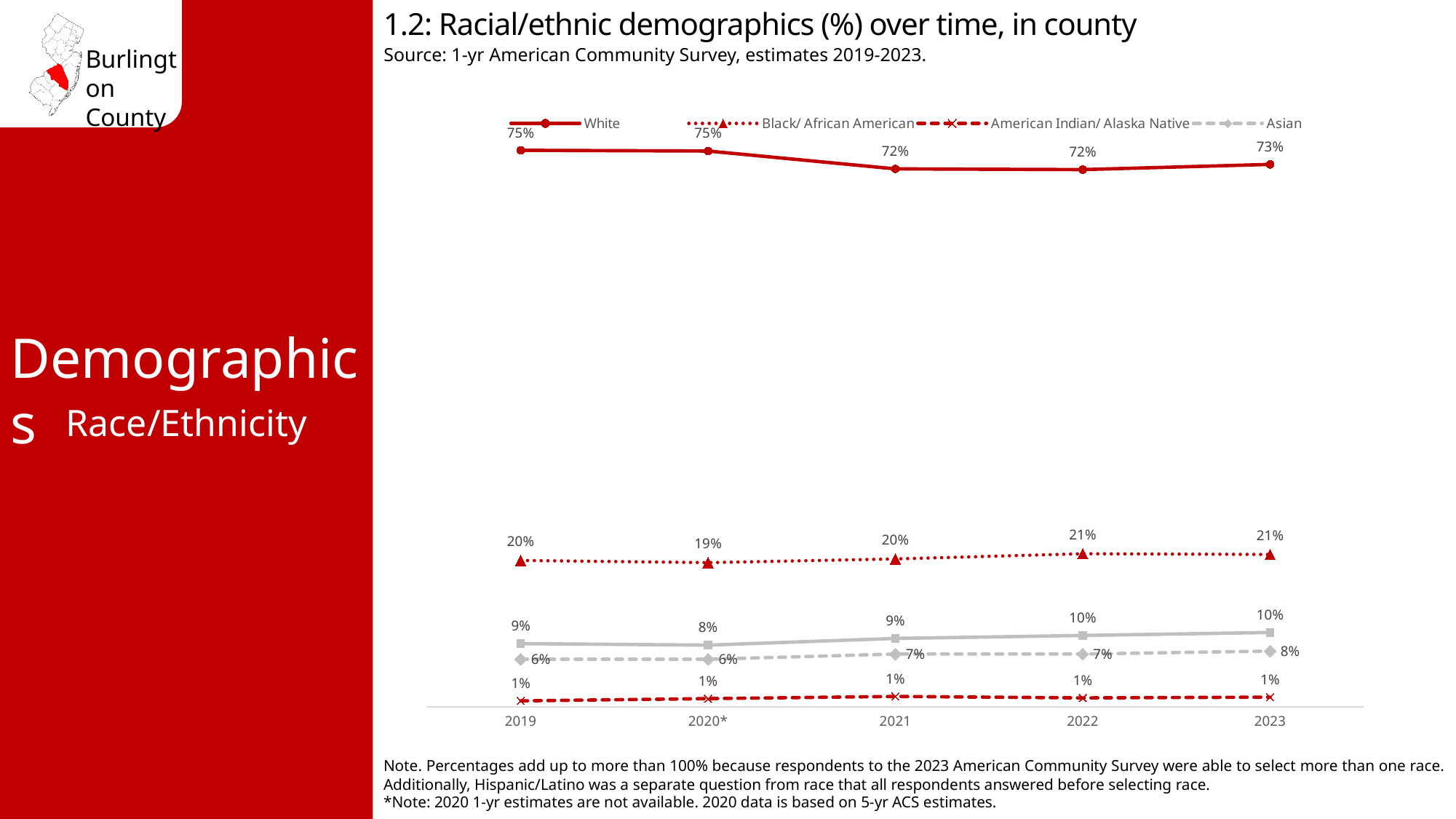
Does the Asian series rise or fall from 2019 to 2023? Rise Which series has the lowest value in 2019? American Indian/ Alaska Native What is the difference between the Black/ African American value and the Asian value in 2023? 13 percentage points Which series has the highest value in 2023? White How many years are shown on the x axis? 5 What is the value for Black/ African American in 2023? 21% What kind of chart is shown on the slide? Line chart What is the value for White in 2021? 72% What is the value for American Indian/ Alaska Native in 2022? 1% By how many percentage points did the White value change from 2019 to 2023? 2 percentage points In 2023, which is larger: the Asian value or the Black/ African American value? Black/ African American What is the value for Asian in 2019? 6%